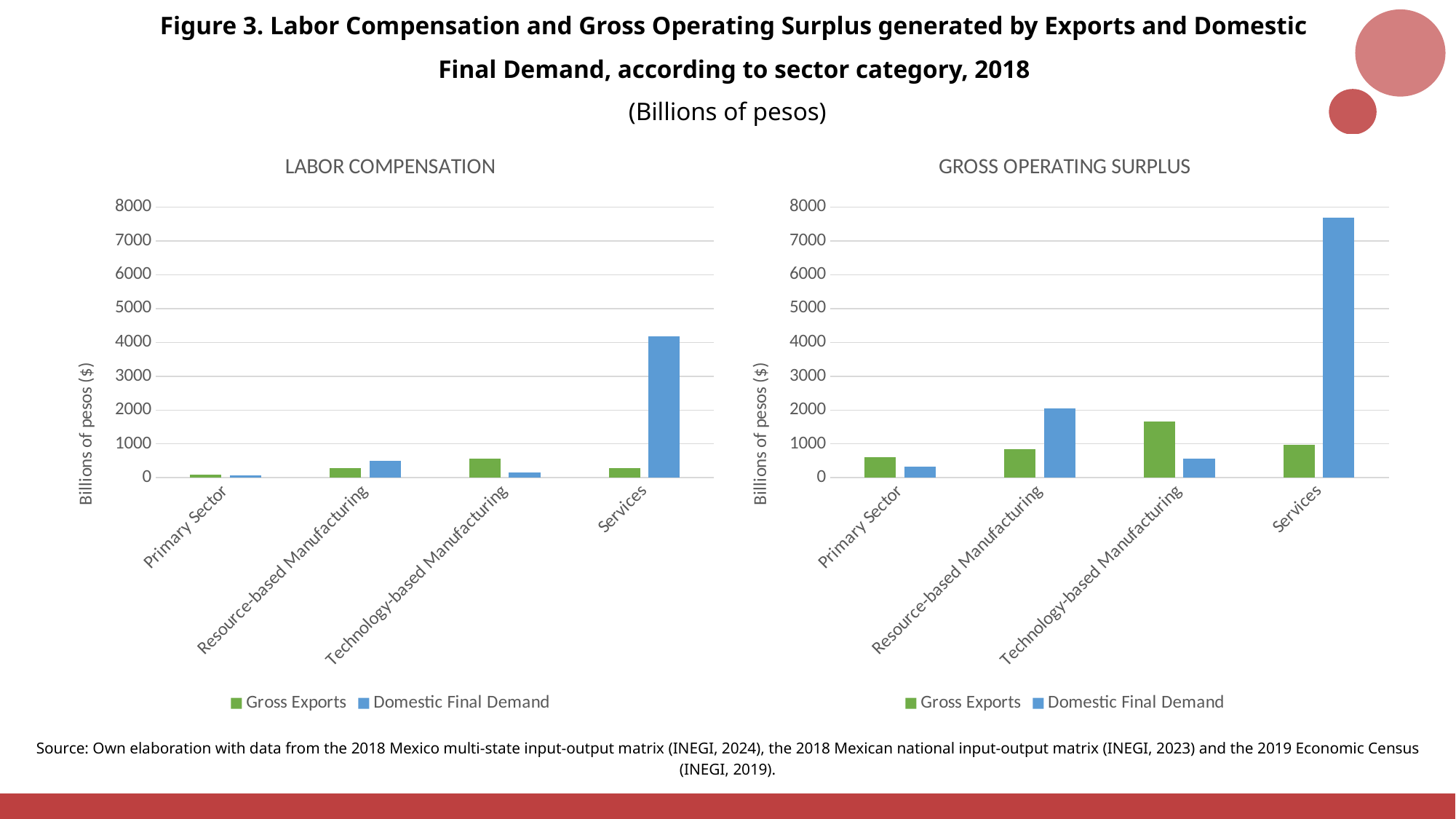
In the GROSS OPERATING SURPLUS chart, is the Domestic Final Demand value for Resource-based Manufacturing greater or less than 1000? greater In the LABOR COMPENSATION chart, which category has the lowest Gross Exports value? Primary Sector In the LABOR COMPENSATION chart, is the Domestic Final Demand value for Services greater or less than 4000? greater In the GROSS OPERATING SURPLUS chart, which category has the highest Gross Exports value? Technology-based Manufacturing What type of chart is the LABOR COMPENSATION chart? Bar chart In the LABOR COMPENSATION chart, for Resource-based Manufacturing, which is larger: Gross Exports or Domestic Final Demand? Domestic Final Demand How many series does the legend of the GROSS OPERATING SURPLUS chart list? 2 How many sector categories are shown on the x axis of the LABOR COMPENSATION chart? 4 In the GROSS OPERATING SURPLUS chart, is the Domestic Final Demand value for Services greater or less than 7000? greater In the GROSS OPERATING SURPLUS chart, which category has the highest Domestic Final Demand value? Services In the LABOR COMPENSATION chart, which category has the highest Domestic Final Demand value? Services In the GROSS OPERATING SURPLUS chart, for Technology-based Manufacturing, which is larger: Gross Exports or Domestic Final Demand? Gross Exports